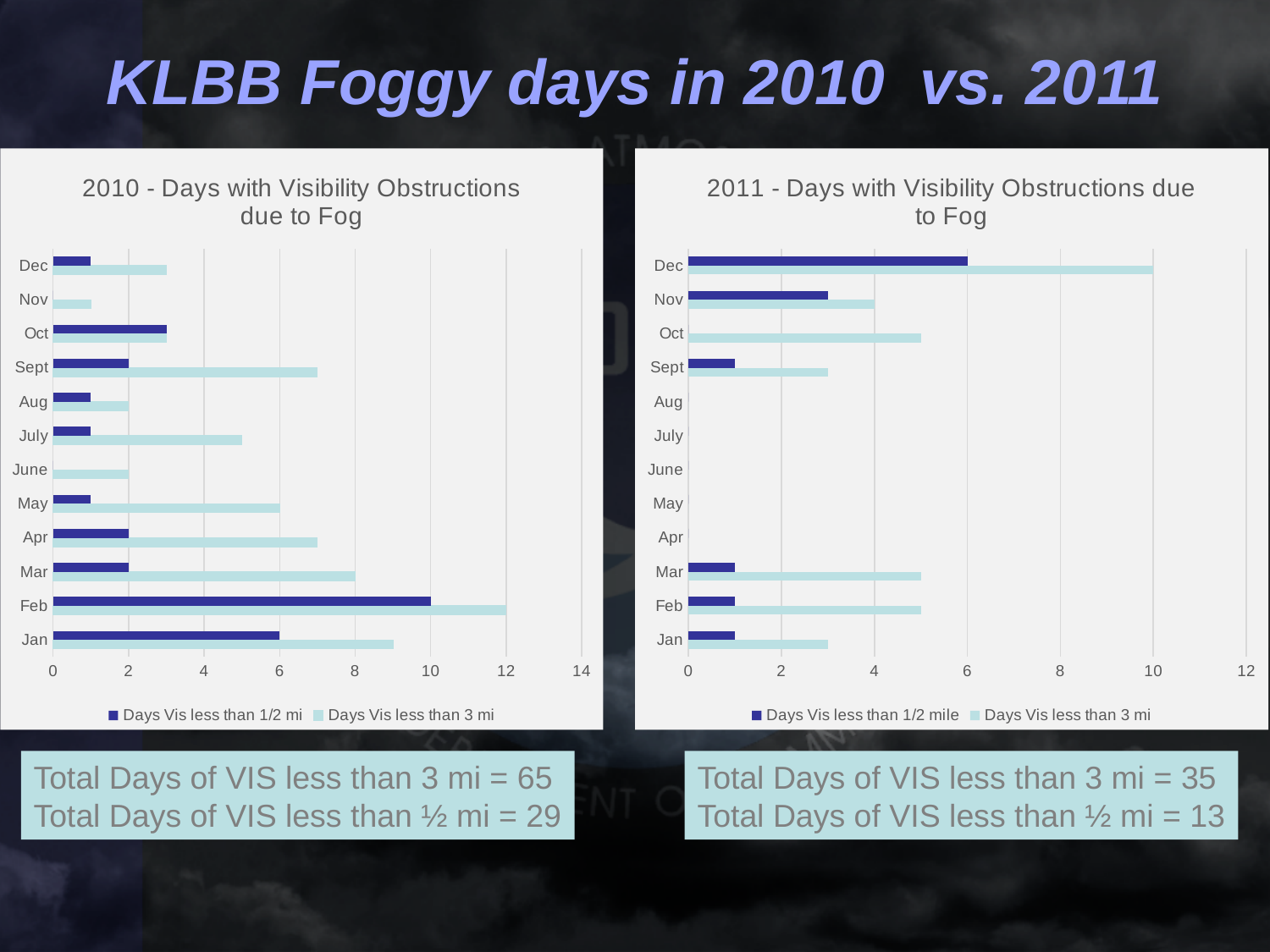
In the 2011 chart, what is the value for Dec in the 'Days Vis less than 1/2 mile' series? 6 In the 2010 chart, what is the value for Mar in the 'Days Vis less than 3 mi' series? 8 In the 2010 chart, is the value for Jan in the 'Days Vis less than 3 mi' series greater or less than 8? greater In the 2010 chart, which month has the highest value for 'Days Vis less than 3 mi'? Feb In the 2011 chart, what is the value for Dec in the 'Days Vis less than 3 mi' series? 10 In the 2010 chart, what is the value for Feb in the 'Days Vis less than 1/2 mi' series? 10 In the 2010 chart, what is the difference between the 'Days Vis less than 3 mi' and 'Days Vis less than 1/2 mi' values for Feb? 2 How many series does the legend of the 2011 chart list? 2 What type of chart is the 2010 chart? Bar chart In the 2011 chart, which month has the highest value for 'Days Vis less than 1/2 mile'? Dec In the 2011 chart, is the value for Oct in the 'Days Vis less than 3 mi' series greater or less than 4? greater In the 2010 chart, which is larger: the 'Days Vis less than 3 mi' value for Sept or for Aug? Sept